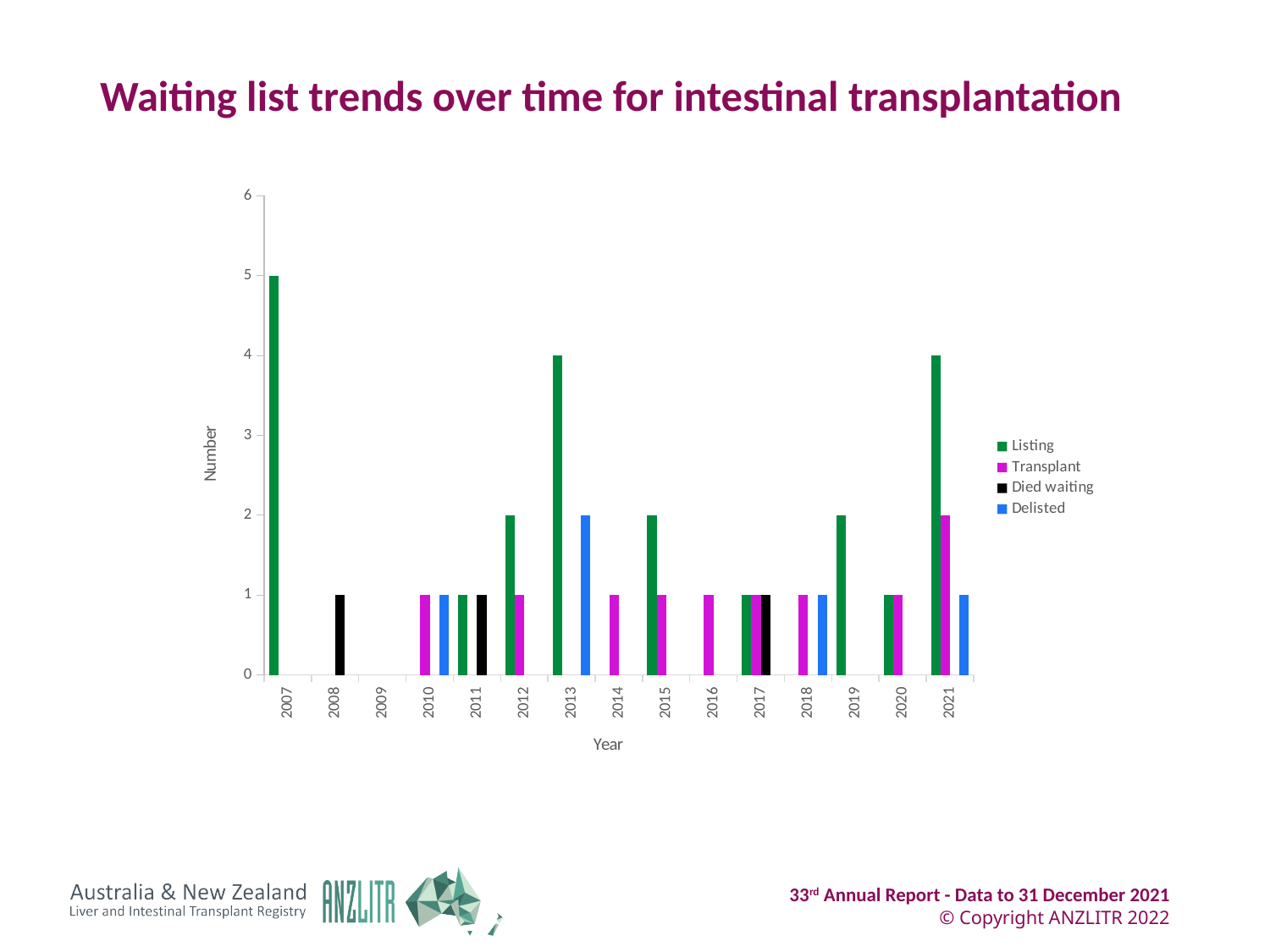
What is the Transplant value for 2021? 2 Which colour represents the Died waiting series in the legend? black What is the Listing value for 2007? 5 Is the Listing value for 2013 greater or less than 3? greater How many series does the legend list? 4 Which is larger in 2021, the Listing value or the Transplant value? Listing In which year is the Listing value highest? 2007 What is the difference between the Listing value in 2007 and the Listing value in 2013? 1 What is the title of the chart? Waiting list trends over time for intestinal transplantation How many years are shown on the x axis? 15 What is the Delisted value for 2013? 2 What type of chart is shown on the slide? bar chart